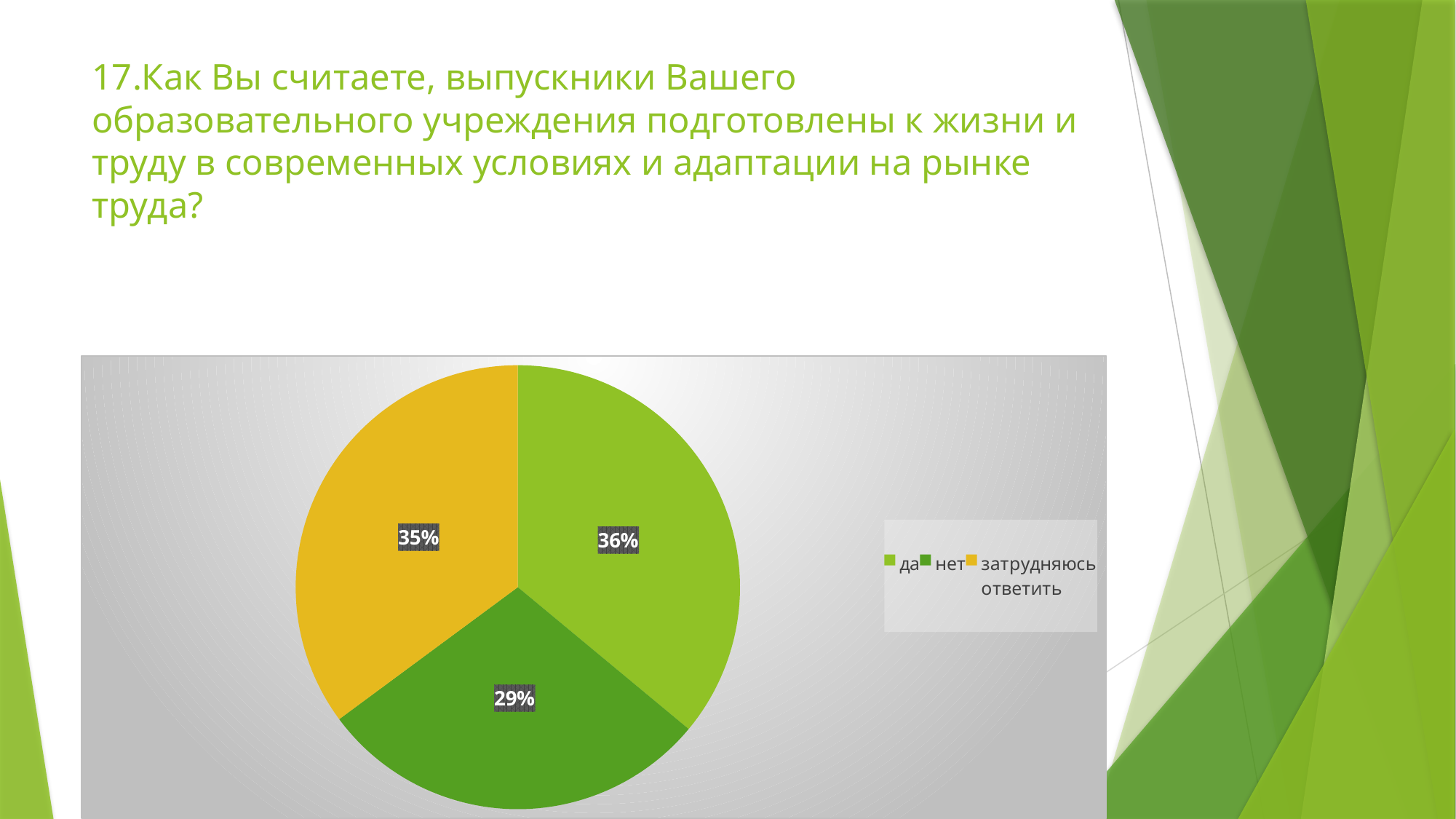
Which answer option has the largest slice of the pie? да What is the difference in percentage points between the "затрудняюсь ответить" slice and the "нет" slice? 6 How many slices does the pie chart have? 3 What percentage of the pie is the "нет" slice? 29% How many entries does the legend list? 3 What colour is the "затрудняюсь ответить" slice in the pie chart? yellow Which answer option has the smallest slice of the pie? нет Which slice is larger, "нет" or "затрудняюсь ответить"? затрудняюсь ответить What percentage of the pie is the "затрудняюсь ответить" slice? 35% What kind of chart is shown on the slide? pie chart What is the difference in percentage points between the "да" slice and the "нет" slice? 7 What percentage of the pie is the "да" slice? 36%